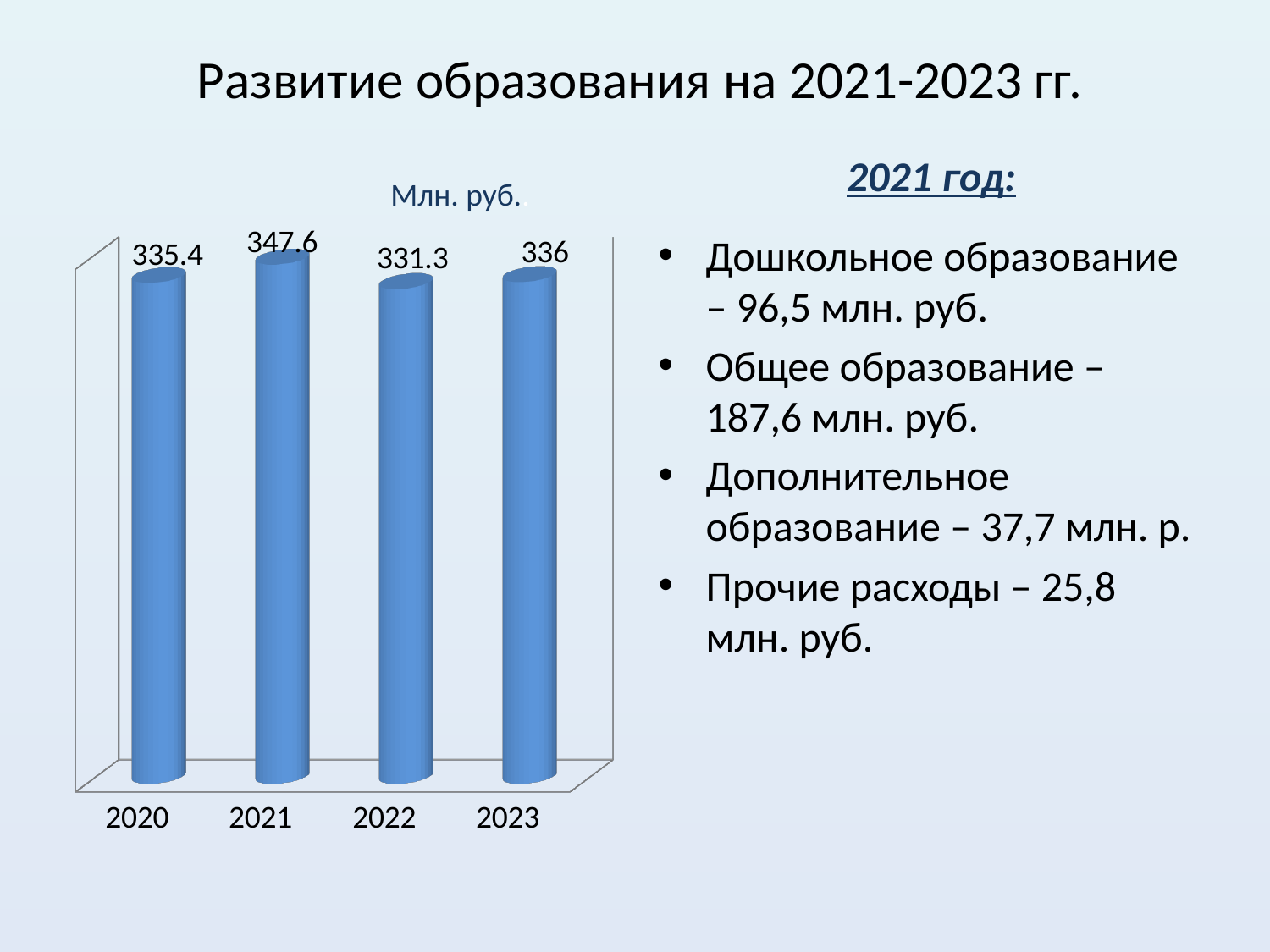
Which year has the highest value? 2021 What kind of chart is shown on the slide? Bar chart What is the value for 2020? 335.4 What is the title of the chart? Млн. руб. What is the difference between the values for 2021 and 2020? 12.2 What is the value for 2021? 347.6 Which is larger, the value for 2020 or the value for 2023? 2023 What is the difference between the values for 2023 and 2022? 4.7 What is the value for 2023? 336 Which year has the lowest value? 2022 What is the value for 2022? 331.3 How many years are shown on the chart? 4